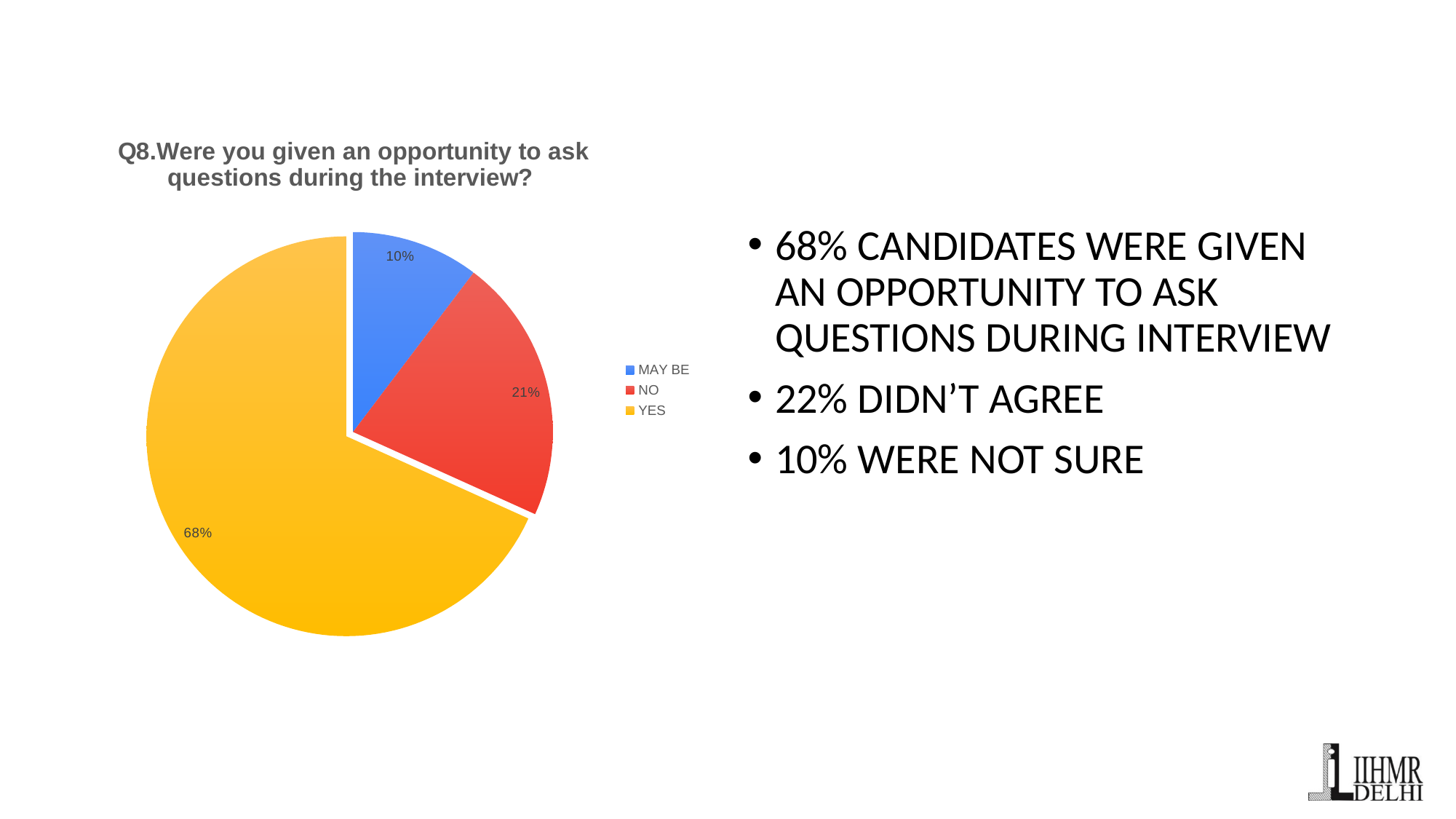
Which slice is larger, NO or MAY BE? NO How many categories does the pie chart have? 3 Which colour represents the YES category in the legend? Yellow What percentage of the pie is the MAY BE slice? 10% What is the title of the chart? Q8.Were you given an opportunity to ask questions during the interview? What percentage of the pie is the NO slice? 21% What kind of chart is shown on the slide? Pie chart Which category has the largest slice of the pie? YES What percentage of the pie is the YES slice? 68% Which category has the smallest slice of the pie? MAY BE What is the difference in percentage points between the YES slice and the NO slice? 47 What is the difference in percentage points between the NO slice and the MAY BE slice? 11